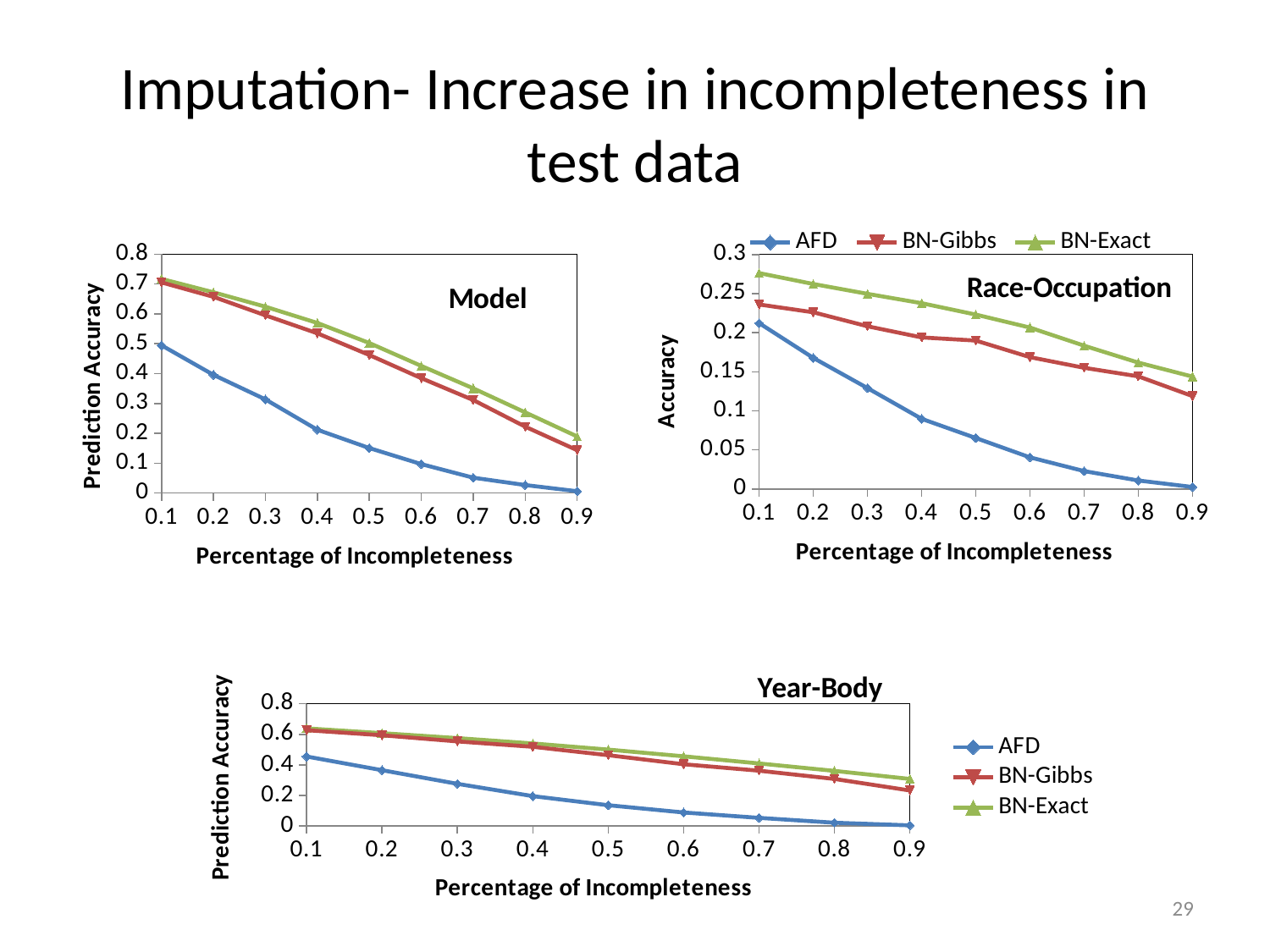
In the Model chart, does the AFD series rise or fall as Percentage of Incompleteness increases? fall In the Year-Body chart, which series has the lowest value at 0.3 Percentage of Incompleteness? AFD In the Race-Occupation chart, how many series does the legend list? 3 In the Race-Occupation chart, which series has the highest value at 0.9 Percentage of Incompleteness? BN-Exact In the Model chart, at 0.5 Percentage of Incompleteness, which is larger, AFD or BN-Gibbs? BN-Gibbs In the Model chart, is the AFD value at 0.5 greater or less than 0.2? less What kind of chart is the Model chart? line chart In the Race-Occupation chart, is the BN-Exact value at 0.1 greater or less than 0.25? greater In the Race-Occupation chart, is the BN-Gibbs value at 0.9 greater or less than 0.1? greater In the Year-Body chart, how many points are plotted along the x axis for each series? 9